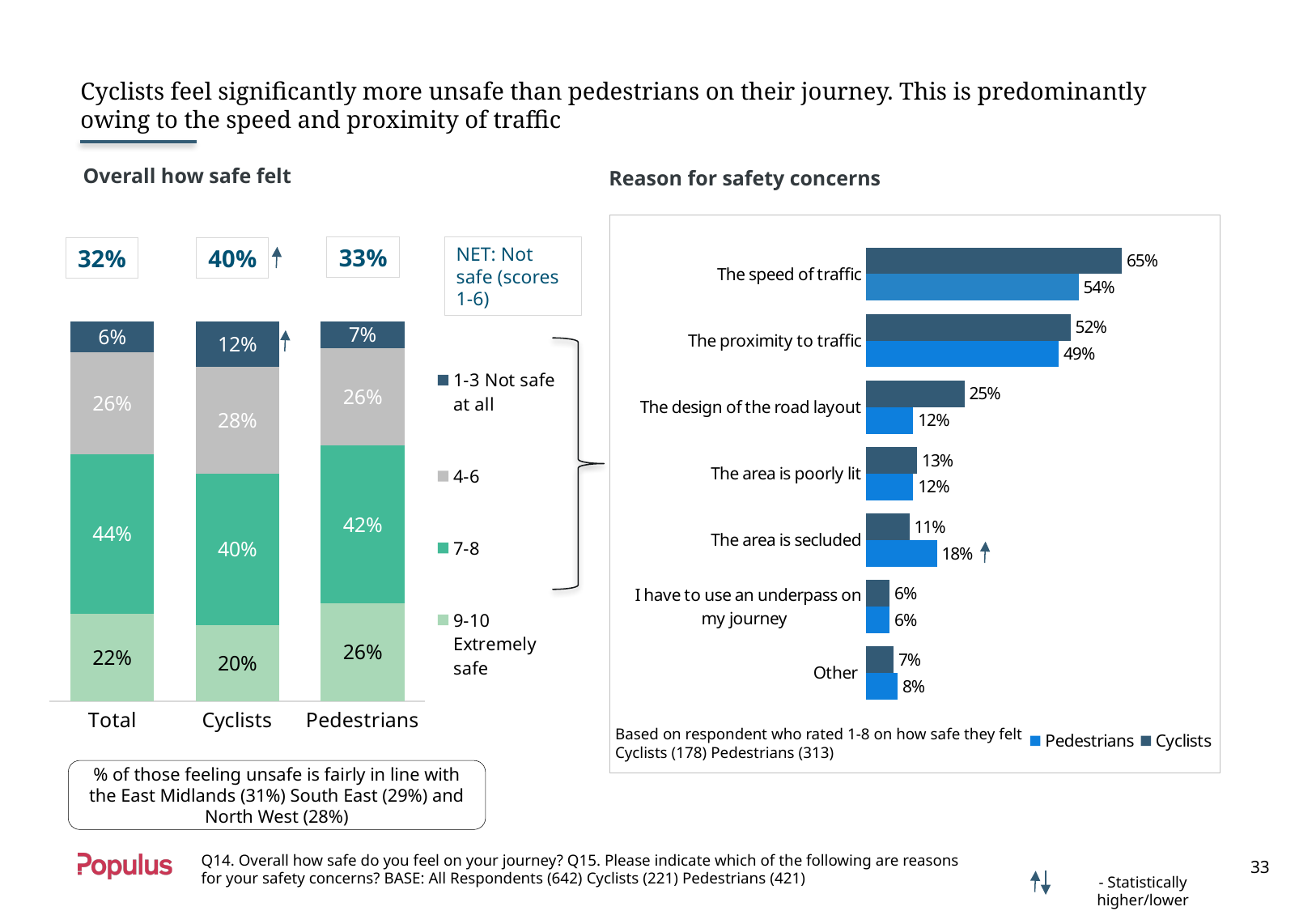
In the 'Reason for safety concerns' chart, which reason has the lowest value for Cyclists? I have to use an underpass on my journey In the 'Overall how safe felt' chart, what is the difference between the 9-10 Extremely safe share for Pedestrians and for Cyclists? 6% In the 'Reason for safety concerns' chart, what percentage of Pedestrians cited the area is secluded? 18% In the 'Reason for safety concerns' chart, what percentage of Cyclists cited the speed of traffic? 65% In the 'Overall how safe felt' chart, how many groups are shown on the x axis? 3 In the 'Reason for safety concerns' chart, which is larger for the area is secluded: Pedestrians or Cyclists? Pedestrians In the 'Overall how safe felt' chart, what percentage of Pedestrians gave a score of 9-10 Extremely safe? 26% In the 'Overall how safe felt' chart, which group has the highest share scoring 7-8? Total What type of chart is 'Overall how safe felt'? Stacked bar chart In the 'Reason for safety concerns' chart, what is the difference between Cyclists and Pedestrians for the design of the road layout? 13% In the 'Overall how safe felt' chart, what percentage of Cyclists gave a score of 1-3 Not safe at all? 12% In the 'Overall how safe felt' chart, how many score bands does the legend list? 4